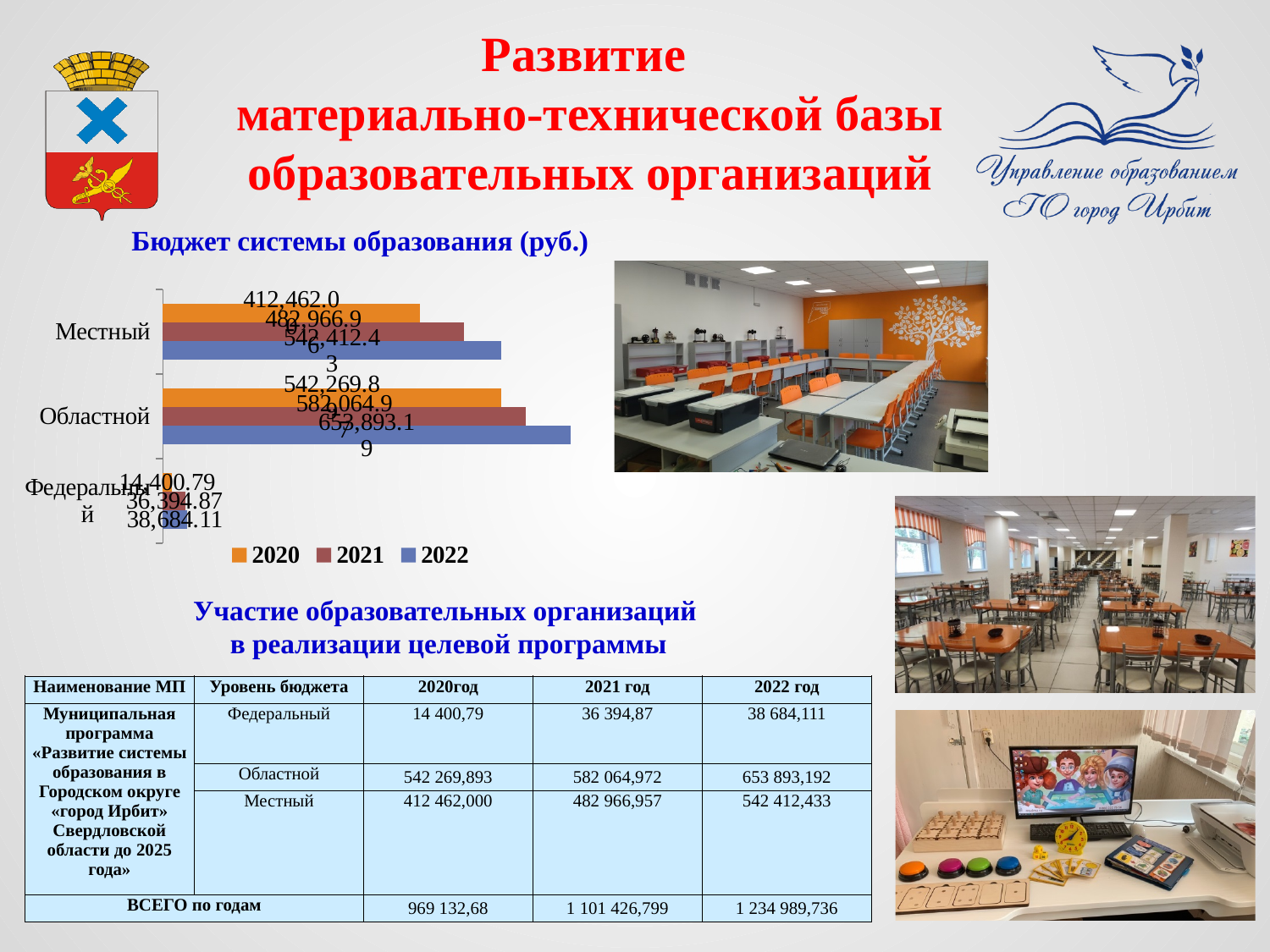
In the 'Бюджет системы образования (руб.)' chart, do the values for Местный rise or fall from 2020 to 2022? rise In the 'Бюджет системы образования (руб.)' chart, what is the value for Федеральный in 2022? 38,684.11 In the 'Бюджет системы образования (руб.)' chart, what is the difference between the Федеральный values for 2022 and 2020? 24,283.32 How many series does the legend of the 'Бюджет системы образования (руб.)' chart list? 3 In the 'Бюджет системы образования (руб.)' chart, which category and year has the longest bar? Областной, 2022 In the 'Бюджет системы образования (руб.)' chart, which category has the smallest values overall? Федеральный Which series is shown in orange in the 'Бюджет системы образования (руб.)' chart? 2020 In the 'Бюджет системы образования (руб.)' chart, what is the value for Федеральный in 2021? 36,394.87 How many budget-level categories are shown on the 'Бюджет системы образования (руб.)' chart? 3 What kind of chart is used for 'Бюджет системы образования (руб.)'? bar chart In the 'Бюджет системы образования (руб.)' chart, which is larger in 2022: Областной or Местный? Областной In the 'Бюджет системы образования (руб.)' chart, what is the value for Федеральный in 2020? 14,400.79